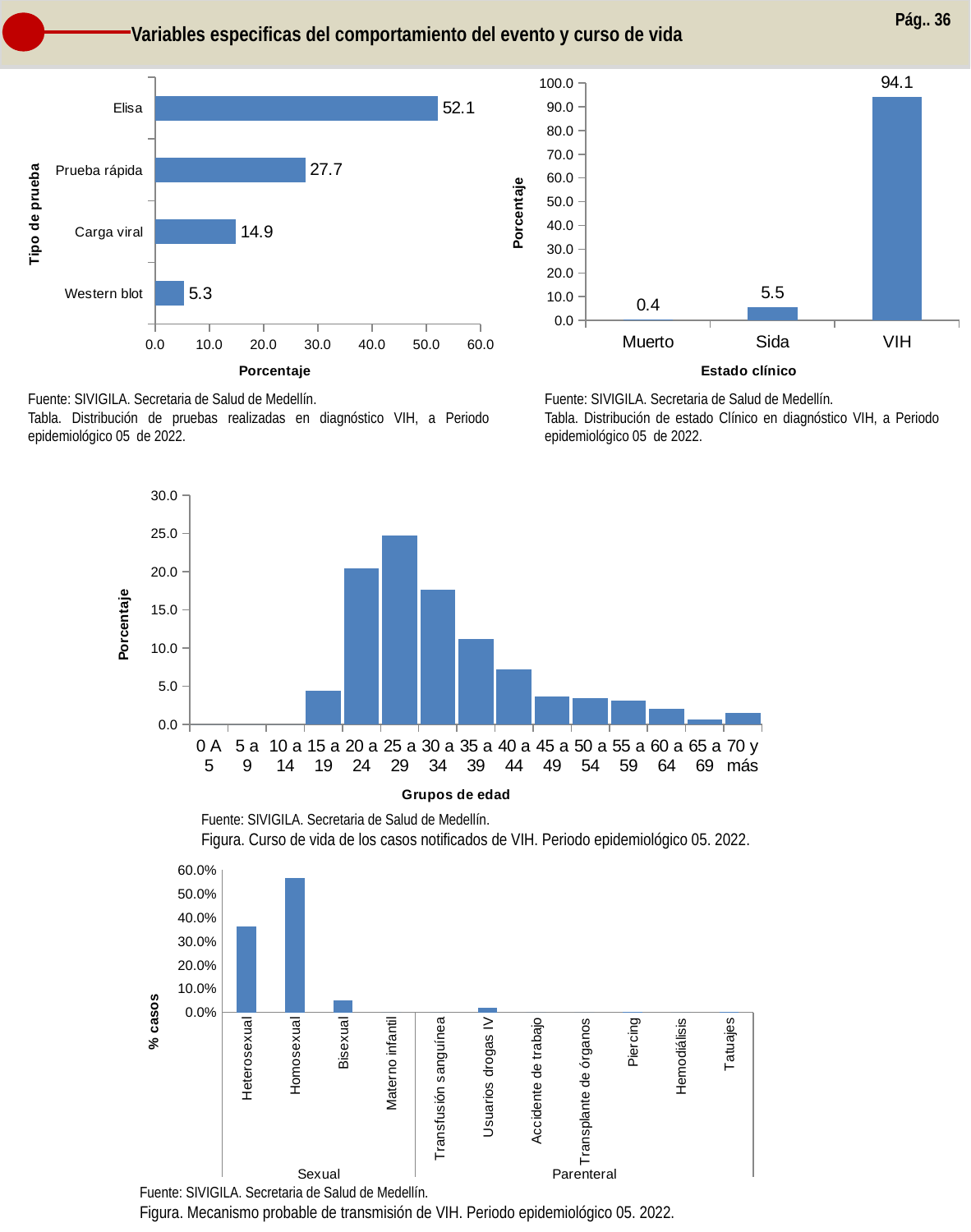
In the middle chart of age groups (Grupos de edad), which age group has the highest percentage? 25 a 29 In the top-left chart of test types (Tipo de prueba), what is the difference between Elisa and Prueba rápida? 24.4 In the bottom chart of transmission mechanism (% casos), which category has the highest value? Homosexual In the top-left chart of test types (Tipo de prueba), which test type has the lowest value? Western blot In the top-left chart of test types (Tipo de prueba), what is the value for Carga viral? 14.9 In the middle chart of age groups (Grupos de edad), how many age groups are shown on the x axis? 15 In the top-right chart of clinical status (Estado clínico), how many categories are shown on the x axis? 3 In the top-right chart of clinical status (Estado clínico), which category has the highest value? VIH In the bottom chart of transmission mechanism (% casos), is the value for Heterosexual greater or less than 30.0%? greater In the top-right chart of clinical status (Estado clínico), what is the value for Sida? 5.5 In the middle chart of age groups (Grupos de edad), is the value for 20 a 24 greater or less than 15.0? greater In the top-left chart of test types (Tipo de prueba), what is the value for Elisa? 52.1